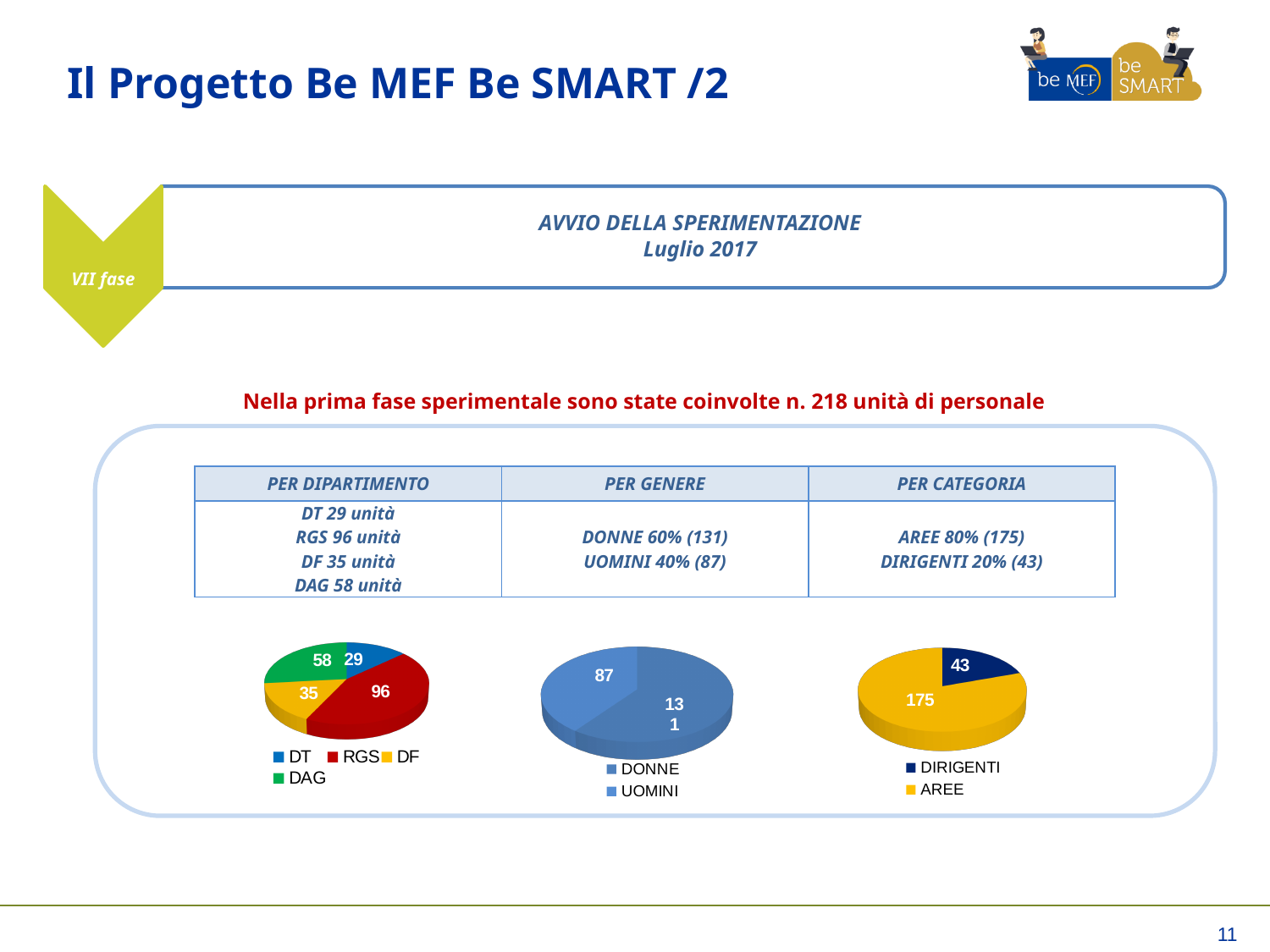
In the left pie chart (per dipartimento), what colour represents RGS in the legend? red In the left pie chart (per dipartimento), what is the value for DAG? 58 What kind of chart is the 'PER DIPARTIMENTO' chart on the left of the slide? pie chart In the left pie chart (per dipartimento), what is the difference between the values for RGS and DT? 67 In the left pie chart (per dipartimento), what is the value for RGS? 96 In the left pie chart (per dipartimento), which department has the largest slice? RGS In the middle pie chart (per genere), what is the value for UOMINI? 87 How many categories does the legend of the left pie chart (per dipartimento) list? 4 In the right pie chart (per categoria), what is the difference between the values for AREE and DIRIGENTI? 132 In the left pie chart (per dipartimento), which department has the smallest slice? DT In the right pie chart (per categoria), what is the value for AREE? 175 In the left pie chart (per dipartimento), which is larger, DF or DAG? DAG